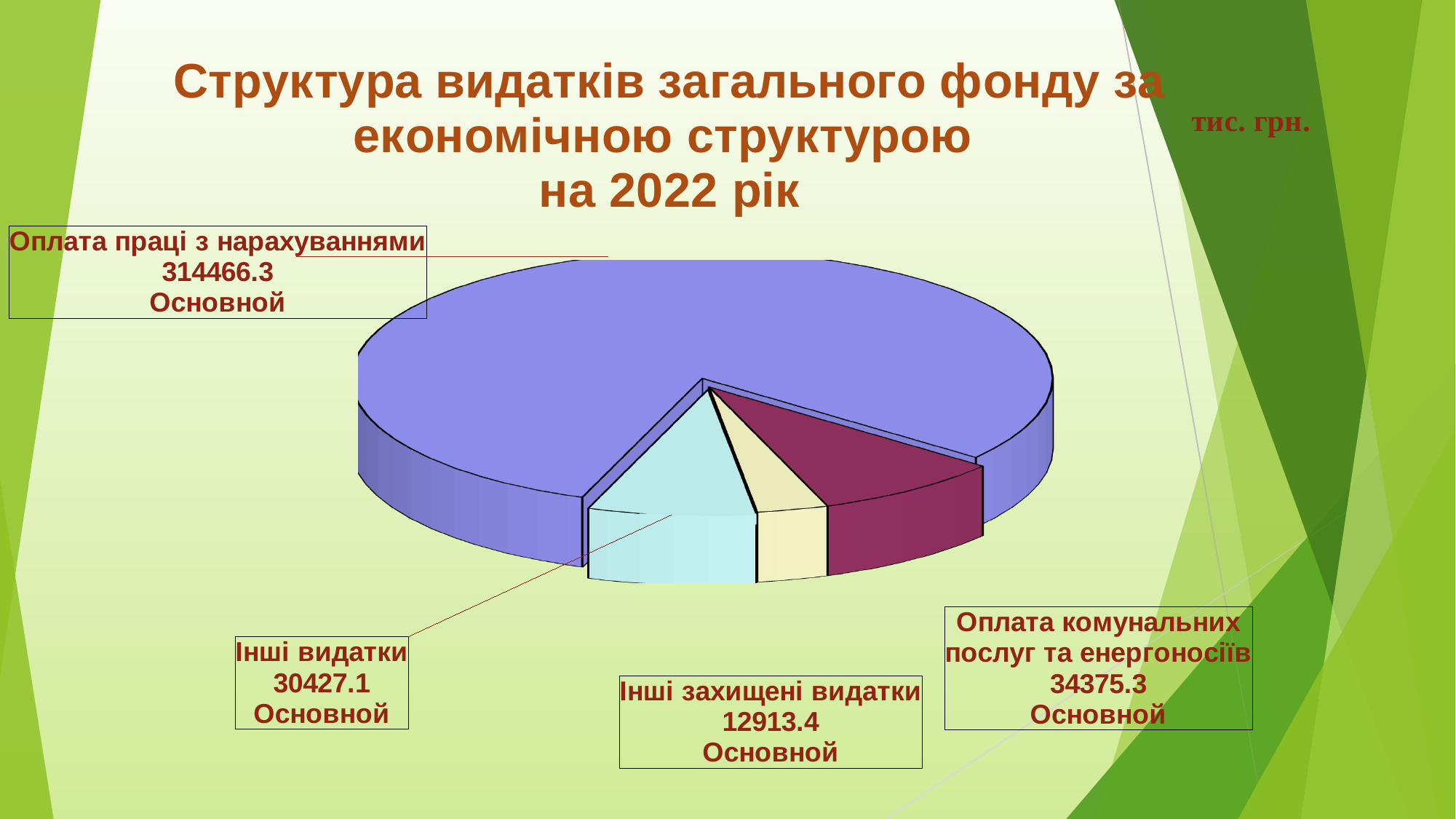
What is the value for Інші видатки? 30427.1 Which category has the smallest slice of the pie? Інші захищені видатки What kind of chart is shown on the slide? Pie chart Which is larger: Оплата комунальних послуг та енергоносіїв or Інші видатки? Оплата комунальних послуг та енергоносіїв What is the value for Оплата комунальних послуг та енергоносіїв? 34375.3 What is the value for Оплата праці з нарахуваннями? 314466.3 How many slices does the pie chart have? 4 What is the value for Інші захищені видатки? 12913.4 What is the difference between Оплата комунальних послуг та енергоносіїв and Інші видатки? 3948.2 Which category has the largest slice of the pie? Оплата праці з нарахуваннями In what units are the values on the chart given? тис. грн. What is the difference between Інші видатки and Інші захищені видатки? 17513.7